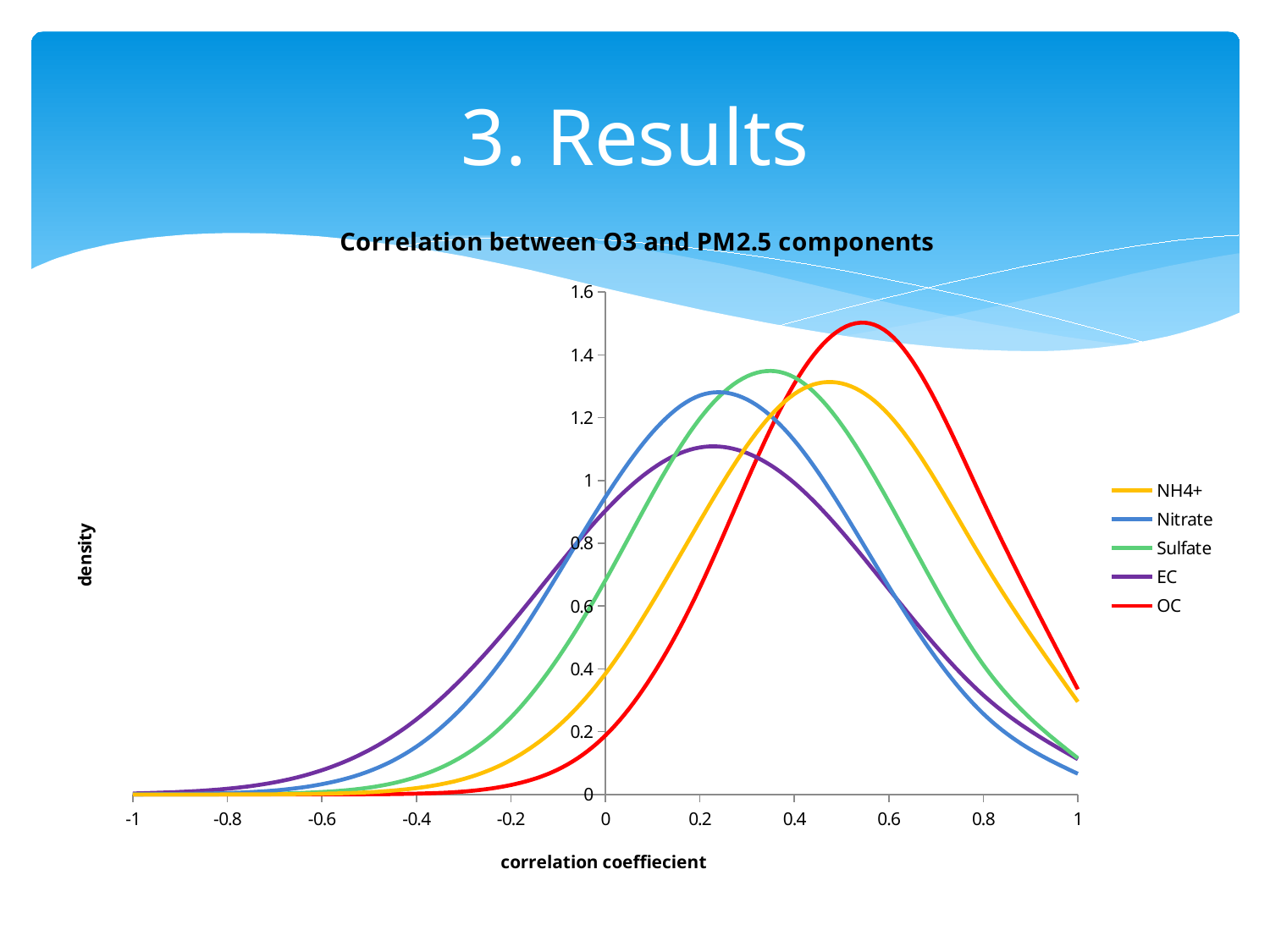
Is the peak density of the Sulfate curve greater or less than 1.2? greater Which series reaches the highest peak density? OC Which has a higher peak density, OC or NH4+? OC What is the title of the chart? Correlation between O3 and PM2.5 components Which series has the lowest peak density? EC Is the density of the Nitrate curve at a correlation coefficient of 1 greater or less than 0.2? less Is the peak density of the EC curve greater or less than 1.2? less What kind of chart is shown on the slide? line chart How many series does the legend list? 5 What is the label of the y axis? density Does the OC curve rise or fall as the correlation coefficient goes from 0.6 to 1? fall